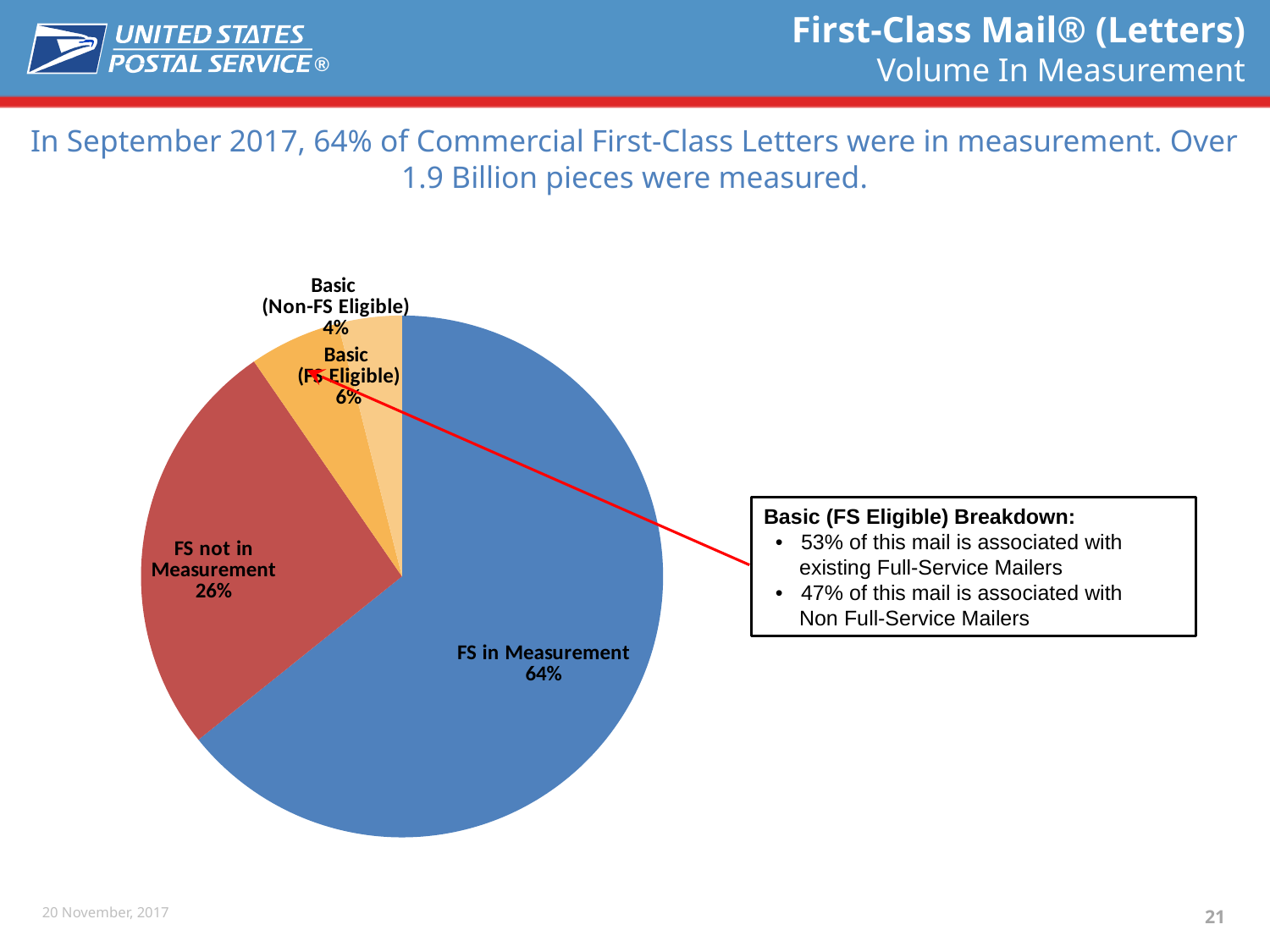
Which slice of the pie is the largest? FS in Measurement According to the callout box, what percentage of Basic (FS Eligible) mail is associated with existing Full-Service Mailers? 53% What kind of chart is shown on the slide? pie chart Which is larger, Basic (FS Eligible) or Basic (Non-FS Eligible)? Basic (FS Eligible) What is the difference in percentage points between FS in Measurement and FS not in Measurement? 38 Which slice of the pie is the smallest? Basic (Non-FS Eligible) What share of the pie is Basic (FS Eligible)? 6% What colour is the FS not in Measurement slice? red What share of the pie is Basic (Non-FS Eligible)? 4% What share of the pie is FS in Measurement? 64% How many slices does the pie chart have? 4